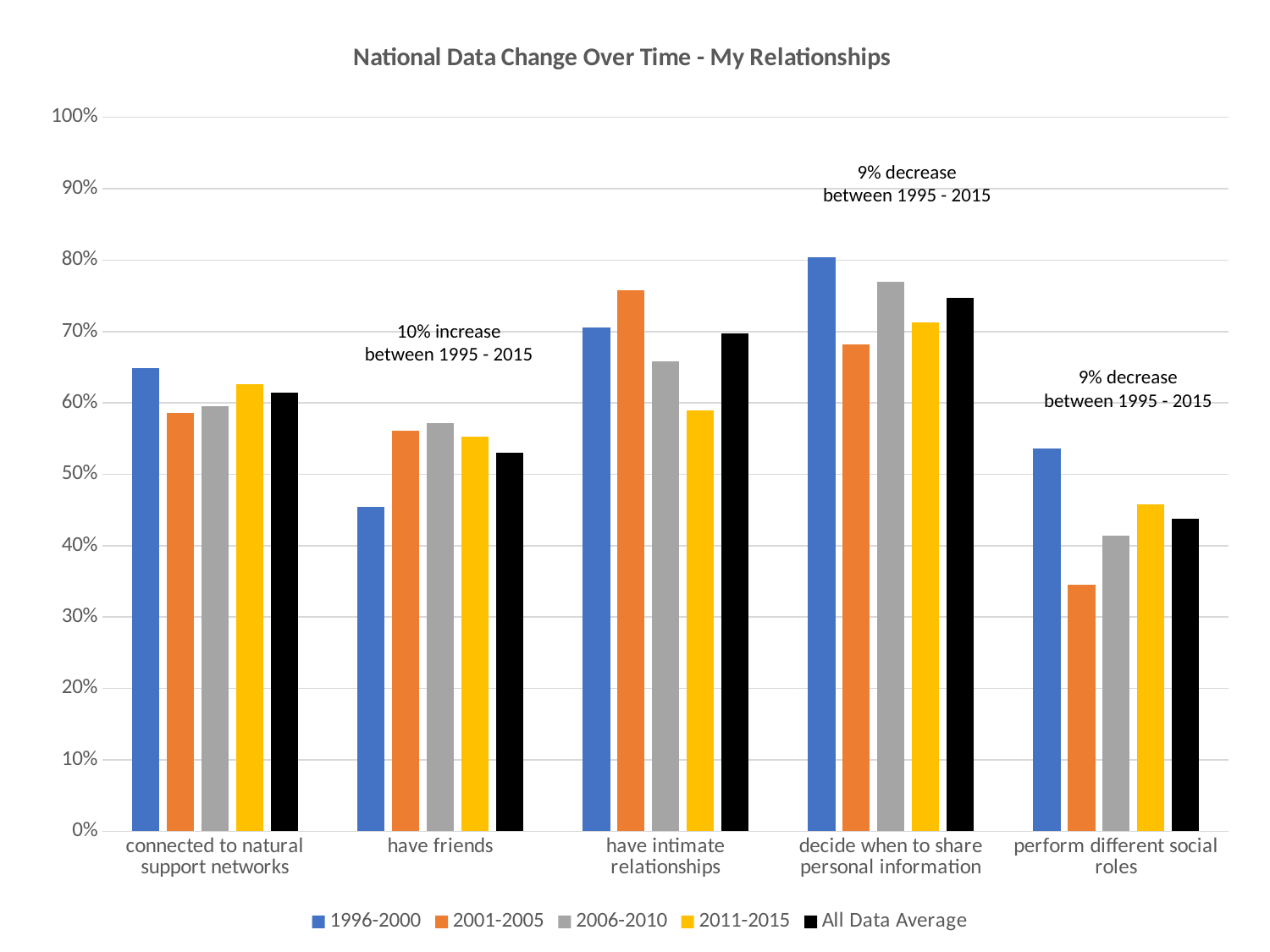
What annotation is shown above the 'have friends' group of bars? 10% increase between 1995 - 2015 Is the 1996-2000 value for 'have friends' greater or less than 50%? less What is the title of the chart? National Data Change Over Time - My Relationships Which category has the highest 1996-2000 bar? decide when to share personal information How many categories are shown along the x axis? 5 How many series does the legend list? 5 What kind of chart is shown on the slide? bar chart Which category has the lowest 2001-2005 bar? perform different social roles Is the 2001-2005 value for 'have intimate relationships' greater or less than 70%? greater For 'have friends', which is larger: the 1996-2000 value or the 2001-2005 value? 2001-2005 For 'perform different social roles', which series has the highest bar? 1996-2000 Is the All Data Average value for 'perform different social roles' greater or less than 50%? less